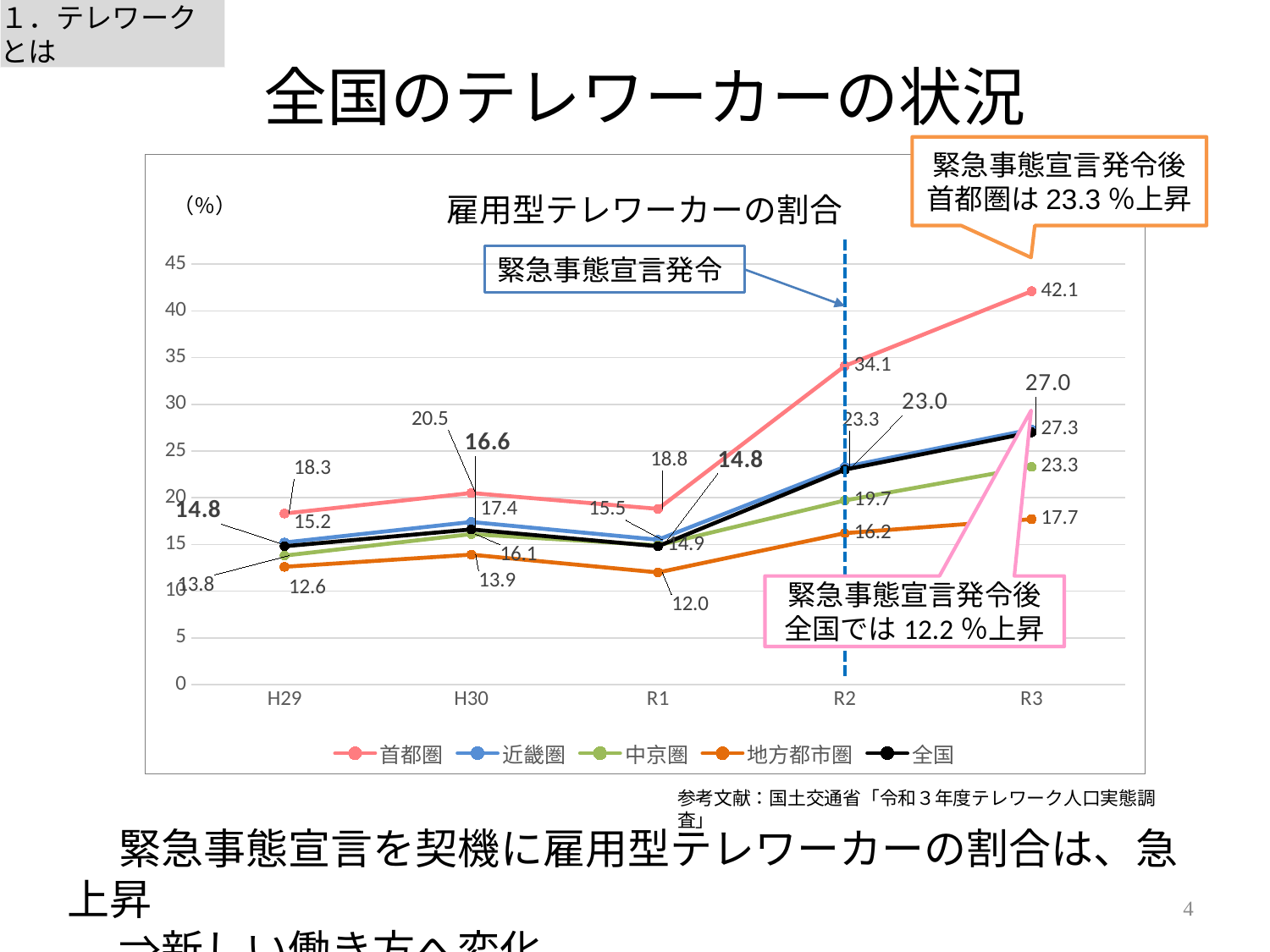
Which series has the highest value at R3? 首都圏 What is the difference between the 首都圏 values at R3 and R2? 8.0 Does the 首都圏 line rise or fall from R1 to R3? Rises What is the value for 首都圏 at R2? 34.1 What is the value for 地方都市圏 at R1? 12.0 What kind of chart is shown? Line chart What is the value for 首都圏 at R3? 42.1 At R3, which is larger: 近畿圏 or 中京圏? 近畿圏 Which series has the lowest value at R3? 地方都市圏 What is the value for 全国 at R3? 27.0 How many series does the legend list? 5 What is the value for 近畿圏 at R3? 27.3